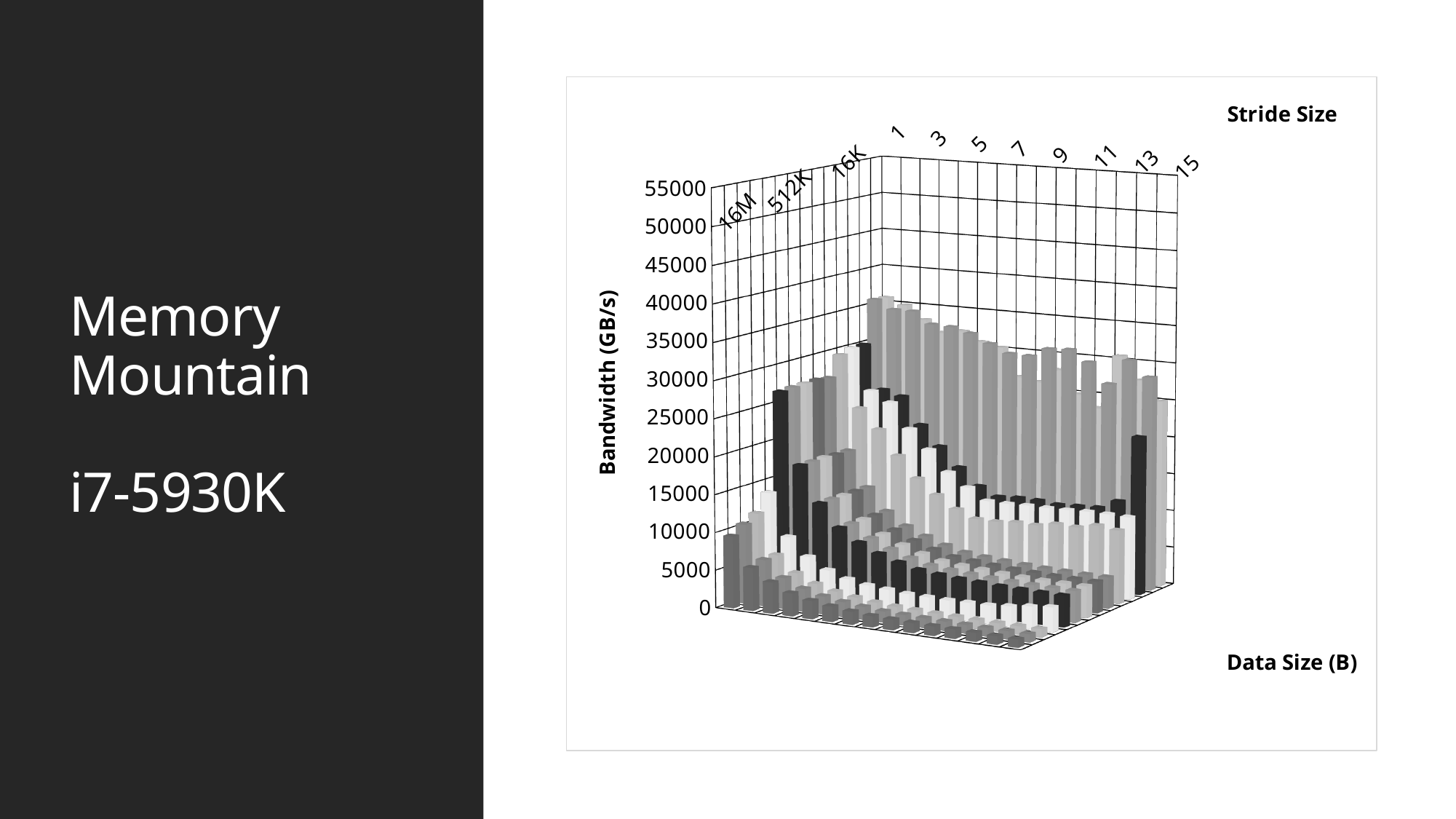
Is the tallest bar in the chart greater or less than 50000 GB/s? less What is the interval between consecutive ticks on the Bandwidth (GB/s) axis? 5000 What is the title of the vertical axis of the chart? Bandwidth (GB/s) What kind of chart is shown on the slide? 3D bar chart What is the highest tick value shown on the Bandwidth (GB/s) axis? 55000 How many stride size labels are shown along the Stride Size axis? 8 What are the two horizontal axes of the chart labelled? Stride Size and Data Size (B) Is the tallest bar in the chart greater or less than 30000 GB/s? greater Along the Stride Size axis, does the bandwidth of the tallest row of bars rise or fall as stride size increases from 1 to 15? fall